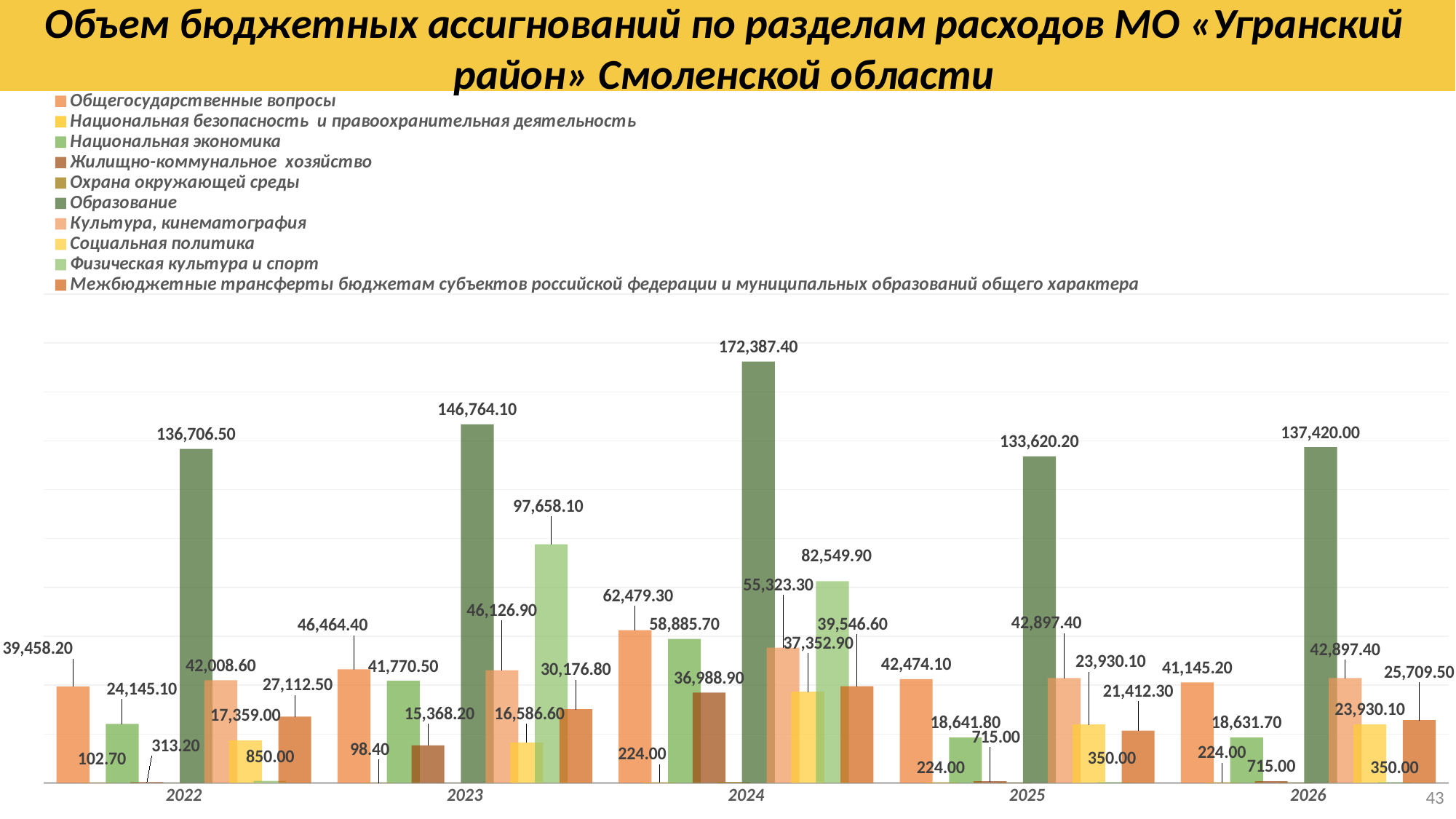
How many series does the legend list? 10 What is the value for Межбюджетные трансферты бюджетам субъектов российской федерации и муниципальных образований общего характера in 2026? 25,709.50 What is the value for Образование in 2024? 172,387.40 In which year is the value for Образование the highest? 2024 How many years are shown along the x axis? 5 What kind of chart is shown on the slide? Bar chart What is the value for Физическая культура и спорт in 2023? 97,658.10 In which year is the value for Образование the lowest? 2025 What is the difference between the Физическая культура и спорт values for 2023 and 2024? 15,108.20 What is the difference between the Образование values for 2024 and 2023? 25,623.30 Does the value for Общегосударственные вопросы rise or fall from 2022 to 2024? Rise Which year has the larger value for Общегосударственные вопросы, 2023 or 2024? 2024